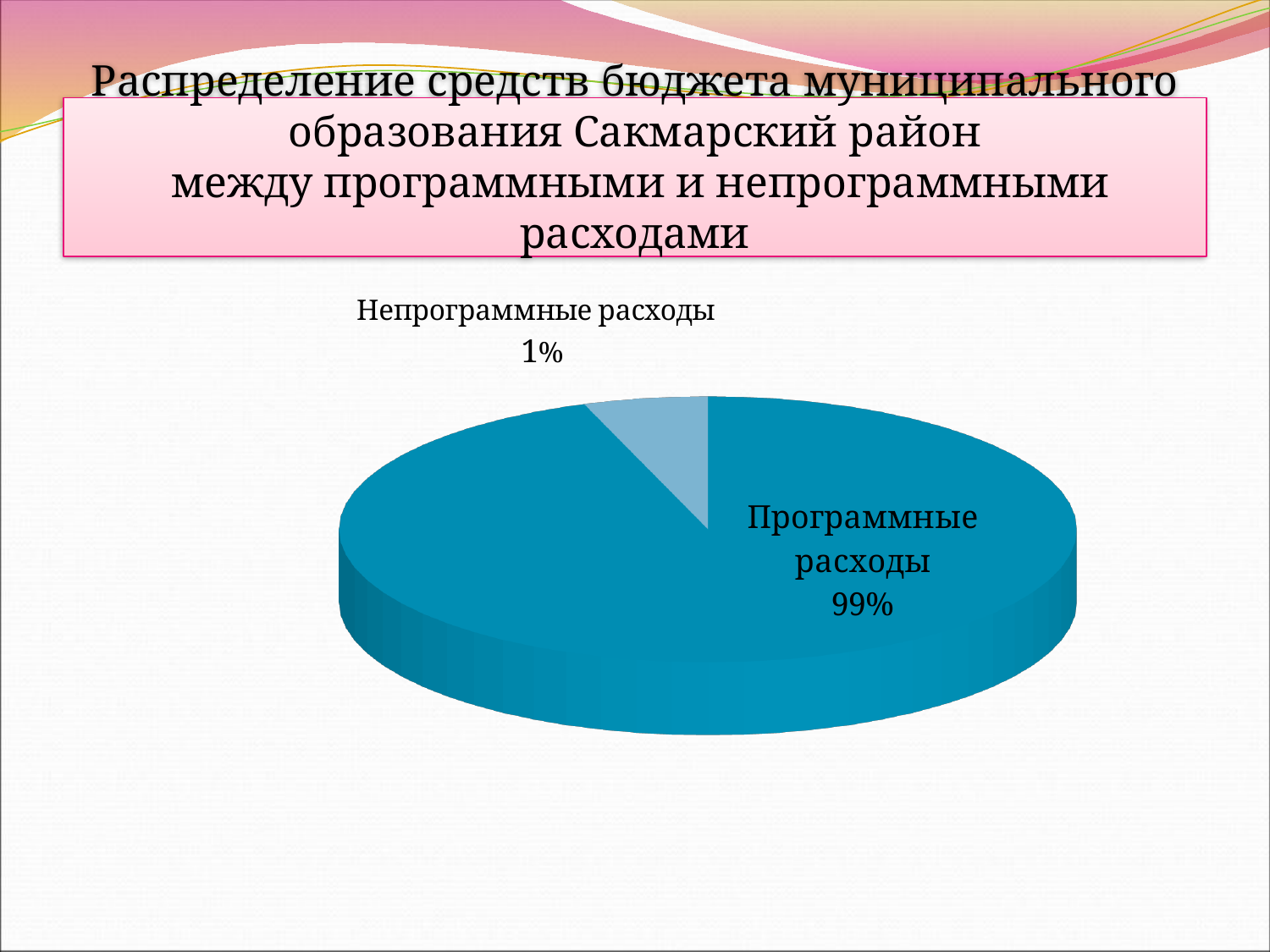
What kind of chart is shown on the slide? pie chart Is the share for "Программные расходы" greater or less than 50%? greater What colour is the slice for "Непрограммные расходы"? light blue How many slices does the pie chart have? 2 What is the difference in percentage points between "Программные расходы" and "Непрограммные расходы"? 98 Which slice of the pie is the largest? Программные расходы What share of the pie is labelled "Программные расходы"? 99% Which is larger: "Программные расходы" or "Непрограммные расходы"? Программные расходы Which slice of the pie is the smallest? Непрограммные расходы What share of the pie is labelled "Непрограммные расходы"? 1% What is the title of the slide containing the pie chart? Распределение средств бюджета муниципального образования Сакмарский район между программными и непрограммными расходами